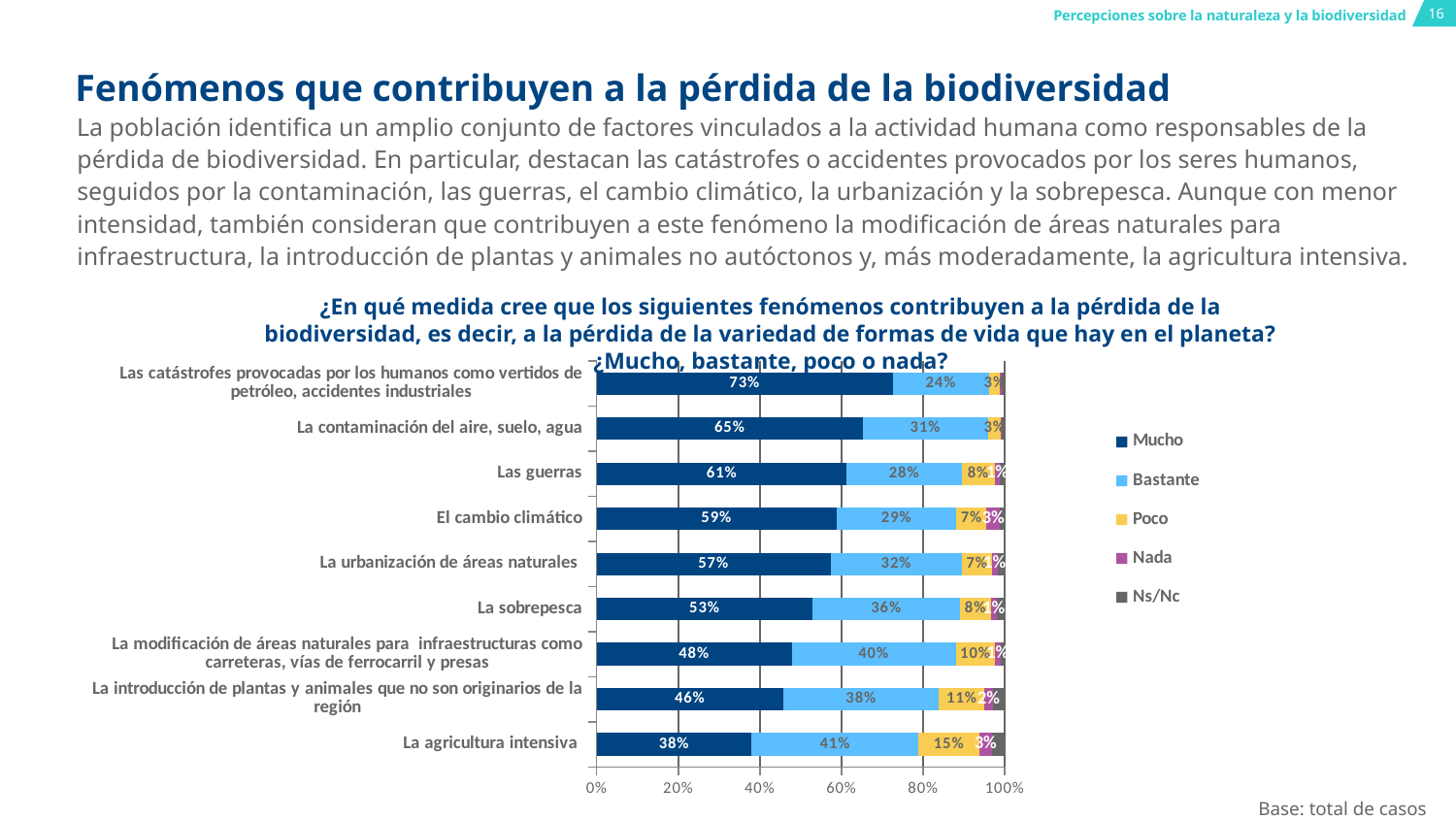
How many series does the legend list? 5 What is the 'Poco' value for 'La agricultura intensiva'? 15% What is the 'Bastante' value for 'La sobrepesca'? 36% Which has a larger 'Bastante' value: 'El cambio climático' or 'La urbanización de áreas naturales'? La urbanización de áreas naturales What is the difference between the 'Mucho' values for 'La contaminación del aire, suelo, agua' and 'Las guerras'? 4% Is the 'Mucho' value for 'La modificación de áreas naturales para infraestructuras como carreteras, vías de ferrocarril y presas' greater or less than 60%? less How many categories (phenomena) are plotted in the chart? 9 What is the 'Mucho' value for 'Las catástrofes provocadas por los humanos como vertidos de petróleo, accidentes industriales'? 73% Which category has the lowest 'Mucho' value? La agricultura intensiva Which legend entry is shown in dark blue? Mucho What kind of chart is shown on the slide? Stacked bar chart Which category has the highest 'Mucho' value? Las catástrofes provocadas por los humanos como vertidos de petróleo, accidentes industriales